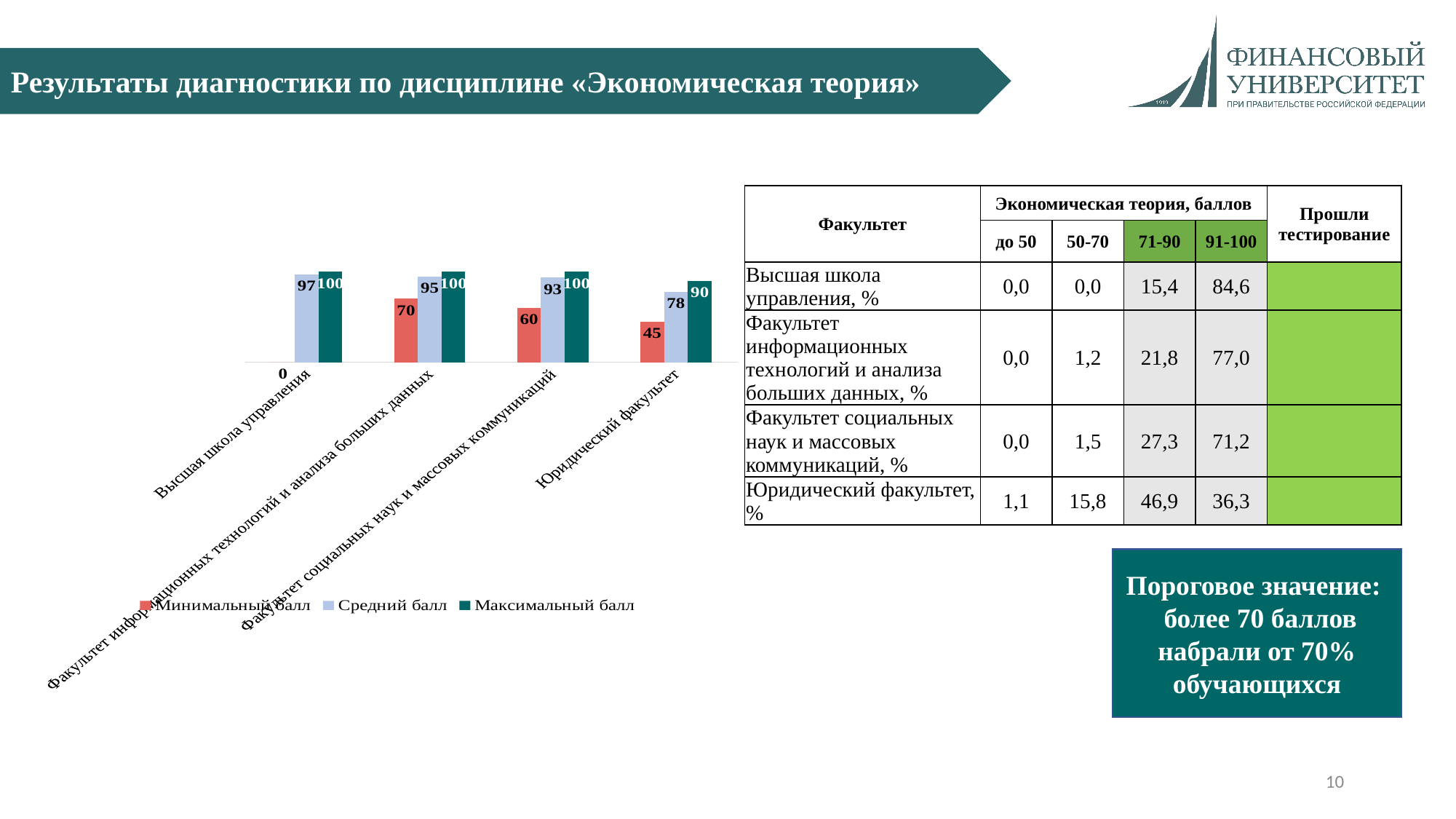
How many series does the chart legend list? 3 What is the Максимальный балл for Юридический факультет? 90 What type of chart is shown on the slide? Bar chart What is the Минимальный балл for Высшая школа управления? 0 How many faculties (categories) are shown on the chart's x axis? 4 Which faculty has the lowest Максимальный балл? Юридический факультет What is the Средний балл for Юридический факультет? 78 Does the Средний балл rise or fall moving from left to right across the faculties on the x axis? Fall What is the Минимальный балл for Факультет социальных наук и массовых коммуникаций? 60 Which faculty has the highest Средний балл? Высшая школа управления What is the difference between the Средний балл of Высшая школа управления and Юридический факультет? 19 Which is larger: the Минимальный балл for Факультет информационных технологий и анализа больших данных or for Юридический факультет? Факультет информационных технологий и анализа больших данных